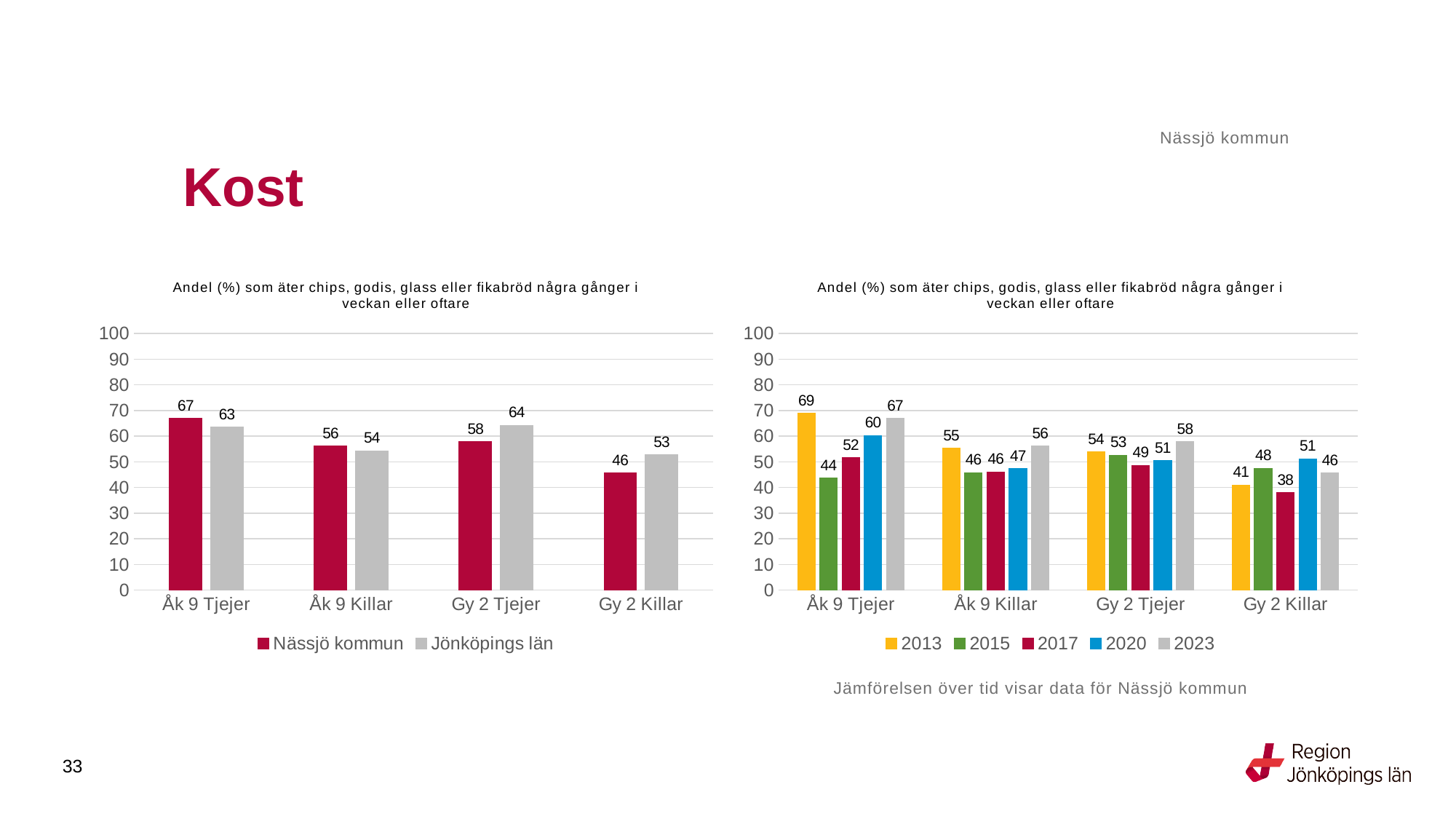
In the left chart, which is larger for Åk 9 Killar: Nässjö kommun or Jönköpings län? Nässjö kommun In the right chart, which year has the highest value for Åk 9 Tjejer? 2013 In the right chart, what is the value for 2020 for Åk 9 Tjejer? 60 In the left chart, what is the value for Nässjö kommun for Åk 9 Tjejer? 67 In the right chart, what is the difference between 2023 and 2013 for Gy 2 Killar? 5 In the left chart, how many series does the legend list? 2 In the right chart, how many series does the legend list? 5 In the left chart, what is the difference between Jönköpings län and Nässjö kommun for Gy 2 Tjejer? 6 In the left chart, what is the value for Jönköpings län for Gy 2 Killar? 53 What type of chart is the right chart? Bar chart In the right chart, what is the value for 2017 for Gy 2 Killar? 38 In the left chart, which category has the lowest value for Nässjö kommun? Gy 2 Killar